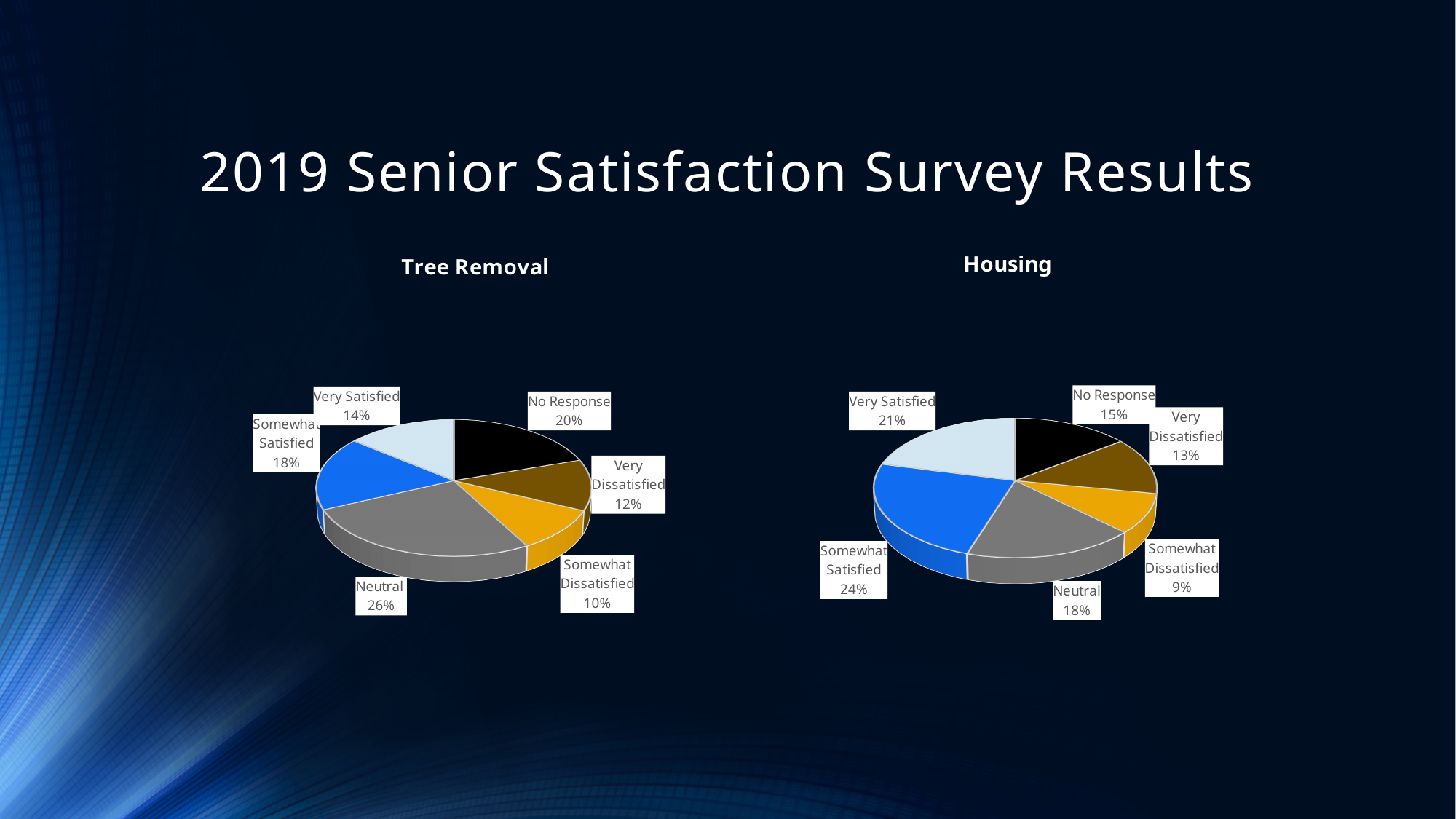
What is the difference between the Very Satisfied shares in the Housing chart and the Tree Removal chart? 7% In the Housing chart, what share is Somewhat Dissatisfied? 9% In the Housing chart, which is larger, Very Dissatisfied or No Response? No Response In the Tree Removal chart, which category has the smallest slice? Somewhat Dissatisfied In the Housing chart, which category has the largest slice? Somewhat Satisfied How many categories does the Tree Removal chart show? 6 In the Tree Removal chart, what share is No Response? 20% In the Tree Removal chart, what share is Neutral? 26% What kind of chart is the Housing chart? Pie chart In the Tree Removal chart, which category has the largest slice? Neutral In the Housing chart, what share is Somewhat Satisfied? 24% In the Housing chart, which category has the smallest slice? Somewhat Dissatisfied